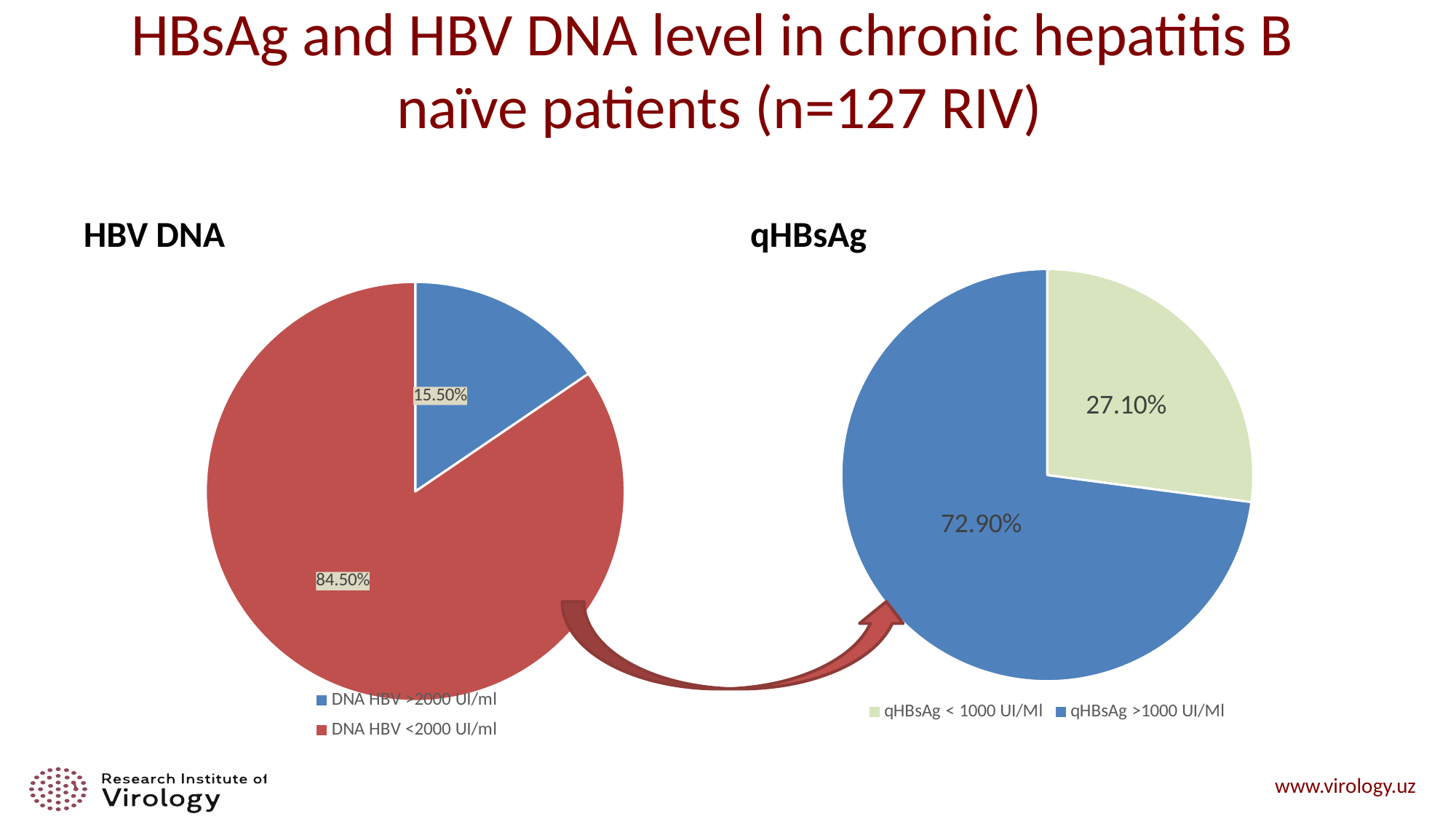
In the qHBsAg pie chart, what colour is the qHBsAg >1000 UI/Ml slice? Blue In the HBV DNA pie chart, what share of patients have DNA HBV >2000 UI/ml? 15.50% Which is larger: the DNA HBV >2000 UI/ml slice in the HBV DNA chart or the qHBsAg < 1000 UI/Ml slice in the qHBsAg chart? qHBsAg < 1000 UI/Ml In the qHBsAg pie chart, what is the difference in percentage points between the qHBsAg >1000 UI/Ml and qHBsAg < 1000 UI/Ml slices? 45.8 percentage points In the HBV DNA pie chart, what share of patients have DNA HBV <2000 UI/ml? 84.50% In the qHBsAg pie chart, what share of patients have qHBsAg >1000 UI/Ml? 72.90% In the HBV DNA pie chart, which category has the largest slice? DNA HBV <2000 UI/ml In the HBV DNA pie chart, what is the difference in percentage points between the DNA HBV <2000 UI/ml and DNA HBV >2000 UI/ml slices? 69 percentage points In the qHBsAg pie chart, which category has the smallest slice? qHBsAg < 1000 UI/Ml How many slices does the qHBsAg pie chart have? 2 In the qHBsAg pie chart, what share of patients have qHBsAg < 1000 UI/Ml? 27.10% What type of chart is the HBV DNA chart? Pie chart